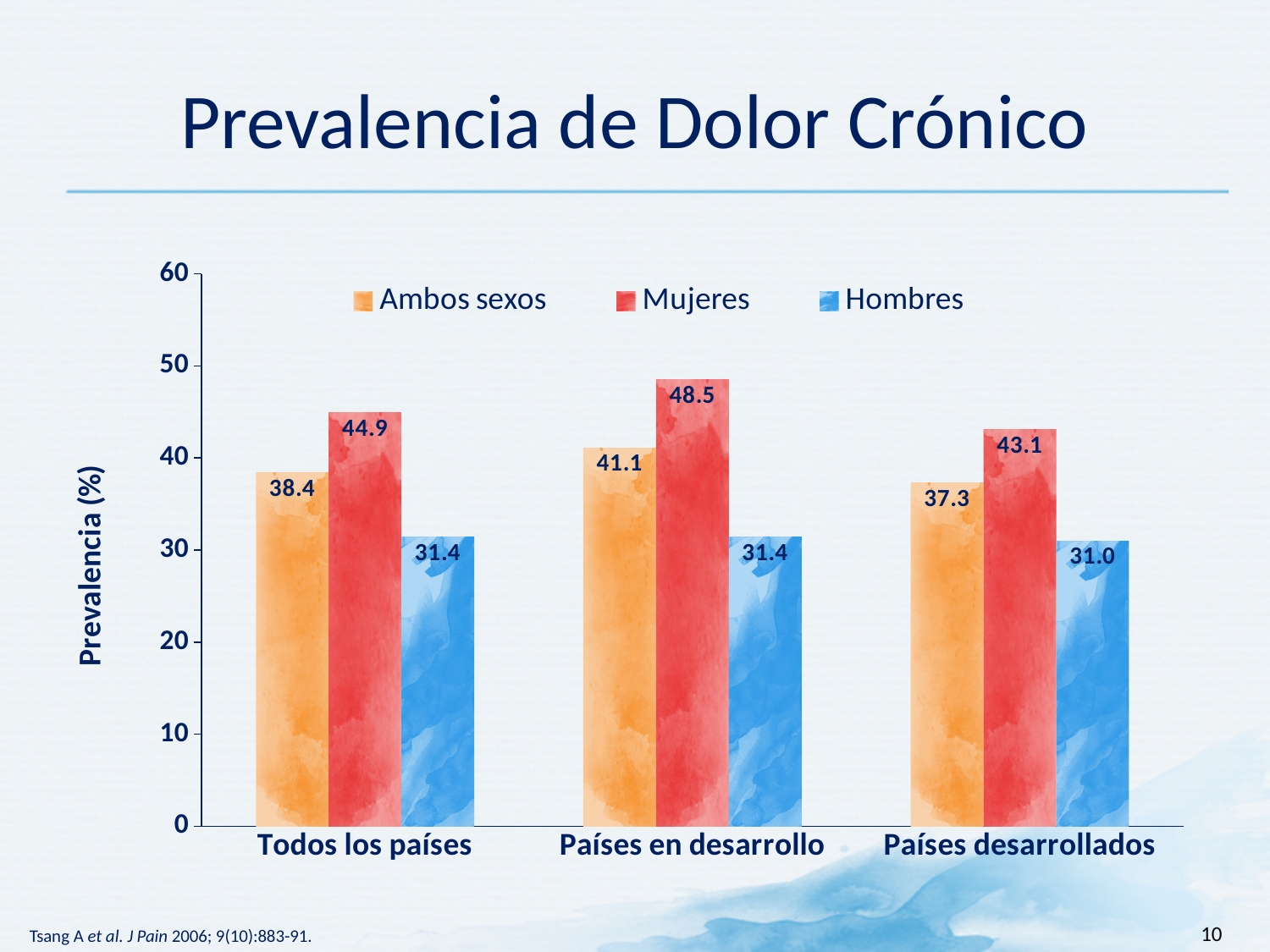
What kind of chart is shown on the slide? Bar chart How many categories are shown on the x axis? 3 What is the label of the y axis? Prevalencia (%) What is the value for Hombres in Países desarrollados? 31.0 What is the value for Ambos sexos in Todos los países? 38.4 Which is larger in Países desarrollados: the value for Ambos sexos or the value for Hombres? Ambos sexos Which category has the highest value for Mujeres? Países en desarrollo What is the value for Mujeres in Países en desarrollo? 48.5 Is the value for Mujeres in Países desarrollados greater or less than 40? greater How many series does the legend list? 3 Which category has the lowest value for Ambos sexos? Países desarrollados What is the difference between the Mujeres and Hombres values in Todos los países? 13.5